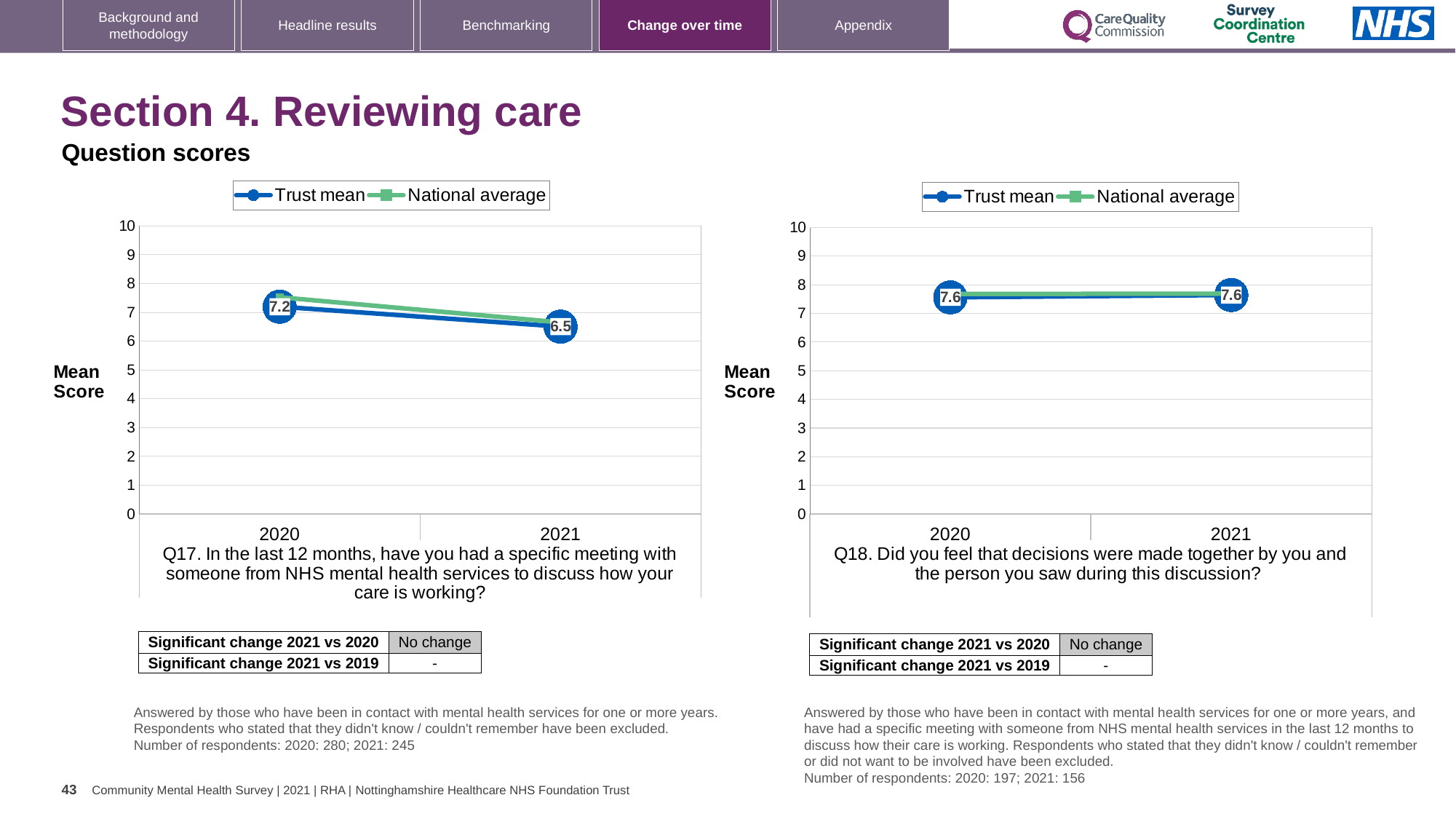
How many years are plotted on the x axis of the Q18 chart on the right? 2 In the Q17 chart on the left, by how much did the Trust mean fall from 2020 to 2021? 0.7 In the Q17 chart on the left, what is the Trust mean for 2020? 7.2 In the Q18 chart on the right, does the Trust mean rise, fall or stay the same from 2020 to 2021? stays the same In the Q17 chart on the left, is the National average for 2020 greater or less than 7? greater In the Q18 chart on the right, what is the maximum value shown on the y axis? 10 In the Q18 chart on the right, what is the Trust mean for 2021? 7.6 In the Q17 chart on the left, does the Trust mean rise or fall from 2020 to 2021? fall In the Q17 chart on the left, what is the Trust mean for 2021? 6.5 What kind of chart is the Q17 chart on the left? line chart How many series does the legend of the Q17 chart on the left list? 2 In the Q17 chart on the left, which is higher in 2020, the Trust mean or the National average? National average